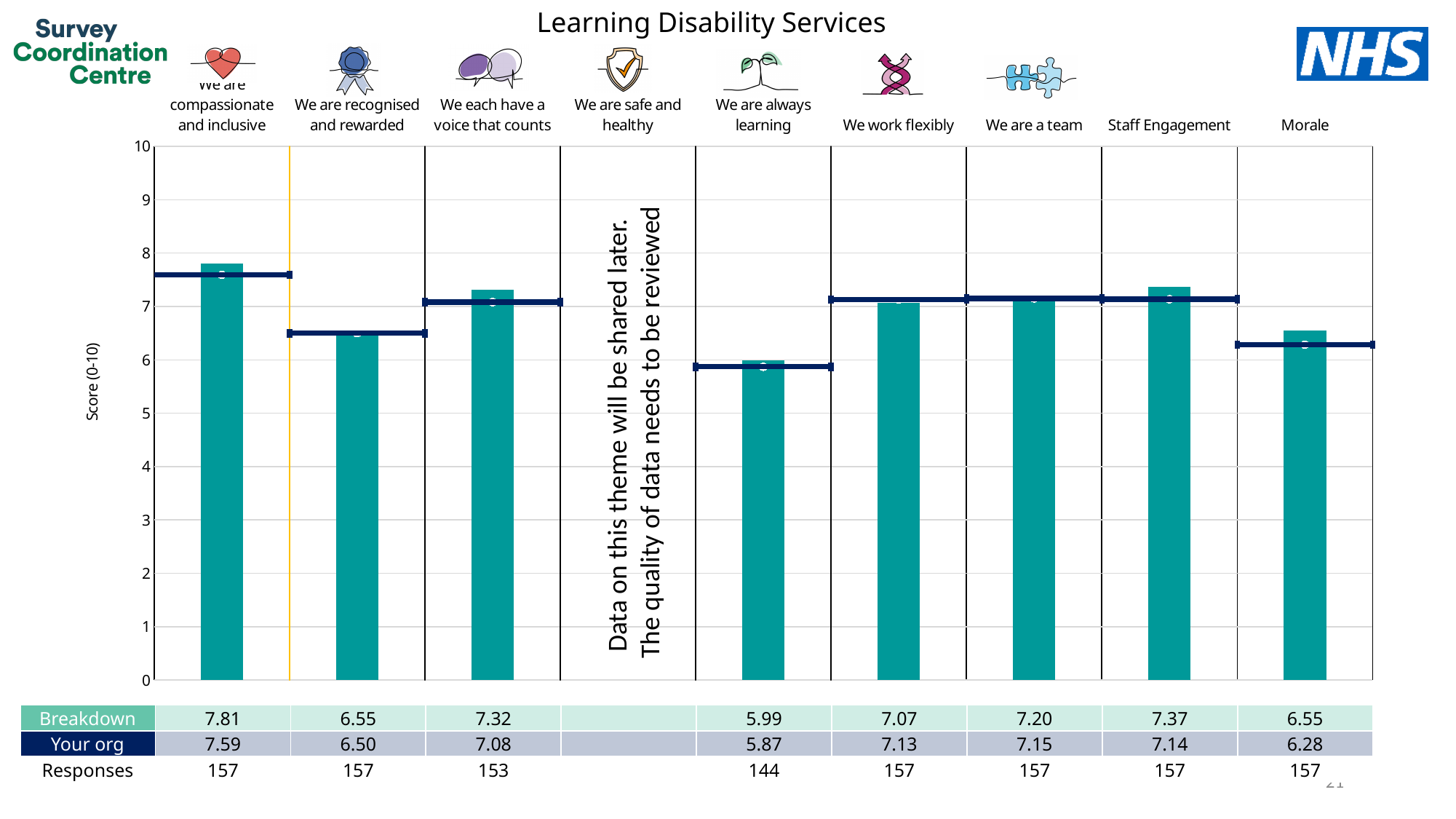
Is the Breakdown bar for 'Morale' greater or less than 6? greater What is the difference between the Breakdown and Your org scores for 'We are compassionate and inclusive'? 0.22 What is the title of the chart? Learning Disability Services Which theme has no data shown on the chart? We are safe and healthy How many themes have a bar plotted on the chart? 8 For 'Staff Engagement', which is larger: the Breakdown score or the Your org score? Breakdown How many responses are recorded for 'We are always learning'? 144 What kind of chart is shown on the slide? bar chart Which theme has the lowest Breakdown score? We are always learning What is the Breakdown score for 'We are compassionate and inclusive'? 7.81 Which theme has the highest Breakdown score? We are compassionate and inclusive What is the Your org score for 'Morale'? 6.28